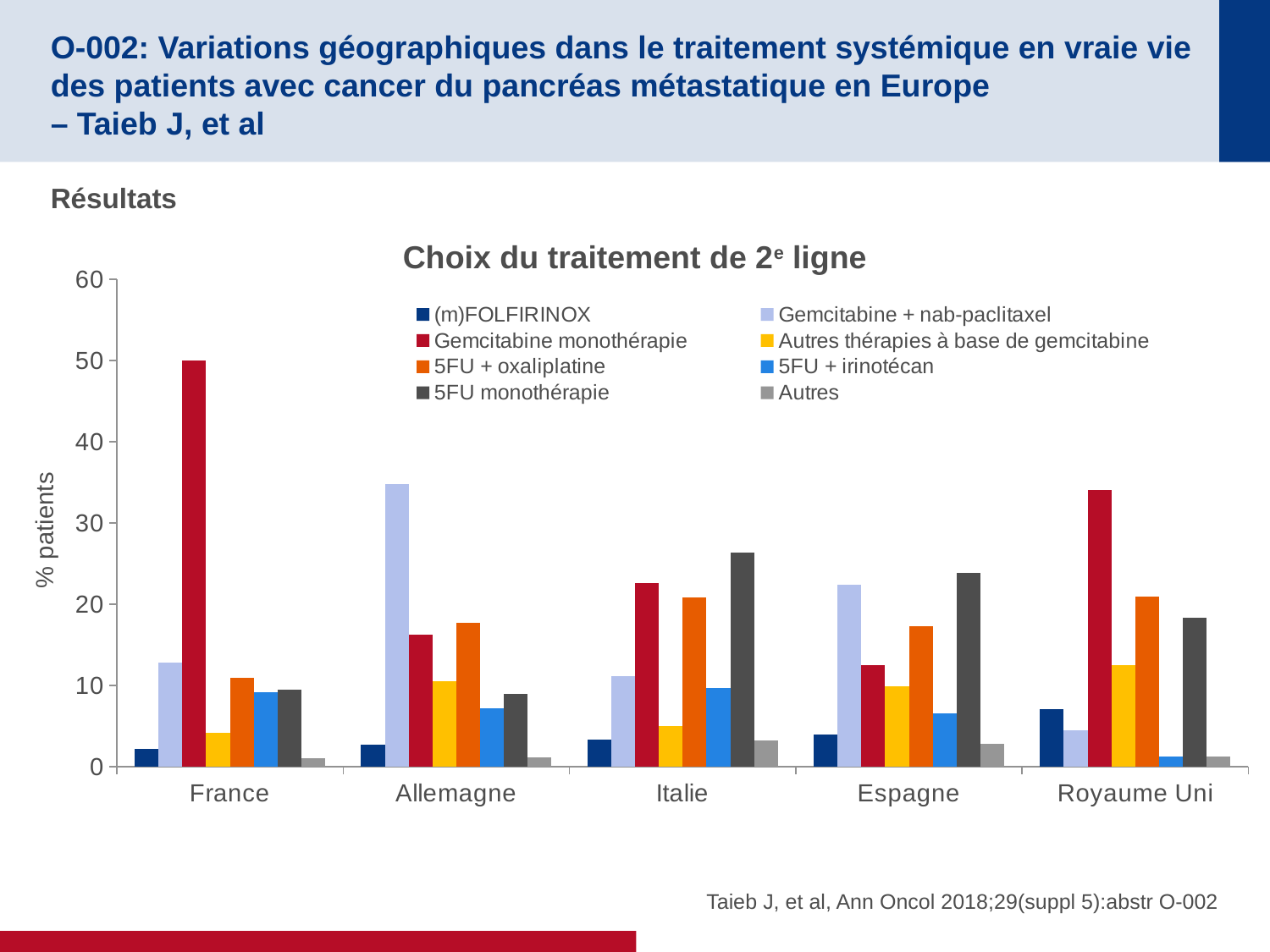
Which country has the highest value for (m)FOLFIRINOX? Royaume Uni How many series does the legend list? 8 Which country has the highest value for Gemcitabine + nab-paclitaxel? Allemagne How many countries are shown on the x axis? 5 Which country has the highest value for Gemcitabine monothérapie? France What kind of chart is shown on the slide? Bar chart Is the value for Gemcitabine + nab-paclitaxel in Allemagne greater or less than 30? greater Which country has the lowest value for Gemcitabine + nab-paclitaxel? Royaume Uni In Royaume Uni, which is larger: Gemcitabine monothérapie or 5FU + oxaliplatine? Gemcitabine monothérapie Is the value for Gemcitabine monothérapie in France greater or less than 40? greater What is the label of the y axis? % patients Is the value for 5FU + irinotécan in Royaume Uni greater or less than 10? less